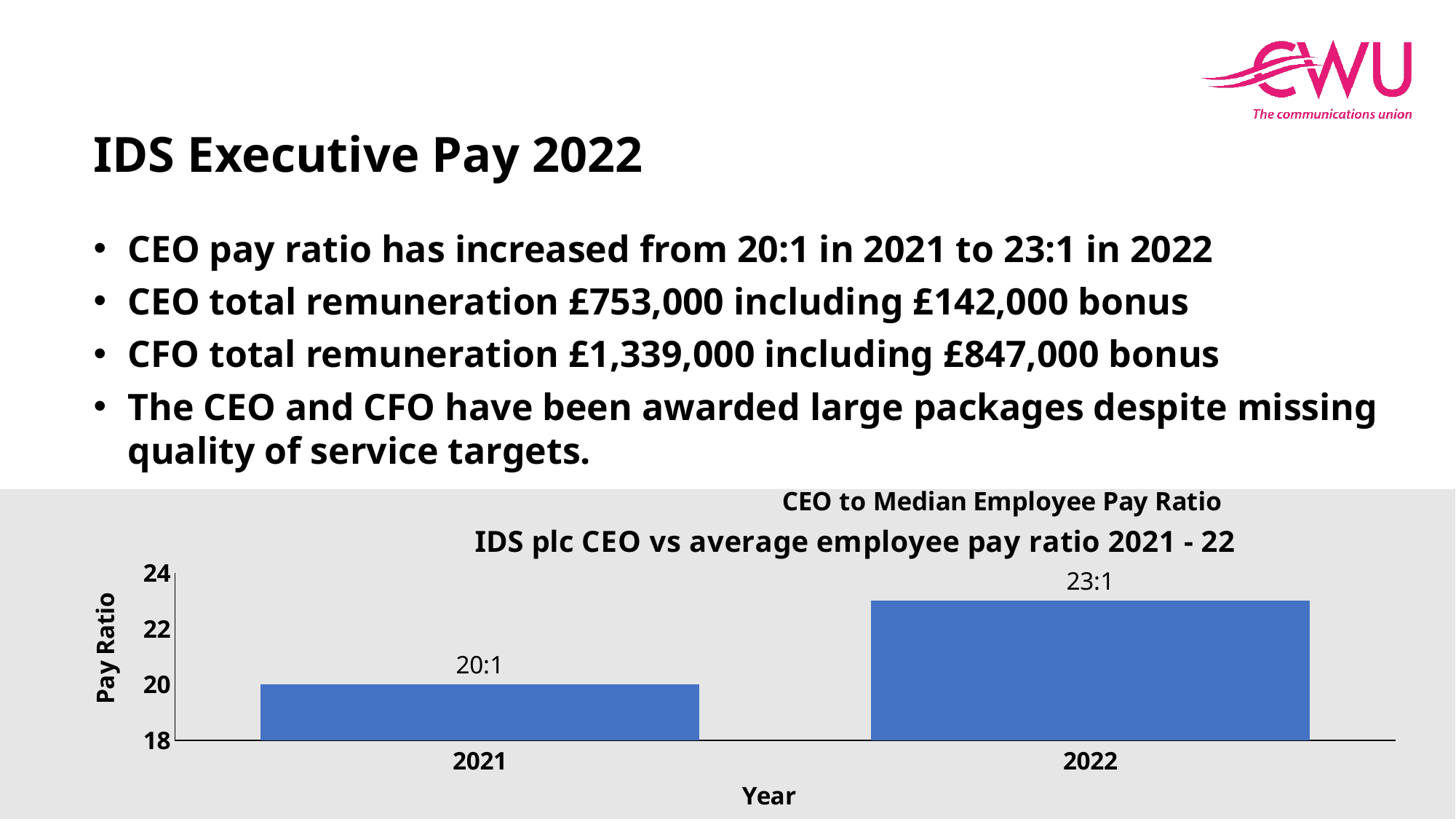
Which year has the lower pay ratio? 2021 Is the pay ratio for 2021 greater or less than 22? less What is the pay ratio shown for 2021? 20:1 What is the pay ratio shown for 2022? 23:1 How many years are plotted on the chart? 2 What kind of chart is shown on the slide? Bar chart What is the label on the horizontal axis of the chart? Year Is the pay ratio for 2022 greater or less than 22? greater Does the pay ratio rise or fall from 2021 to 2022? Rise Which year has the higher pay ratio? 2022 What is the label on the vertical axis of the chart? Pay Ratio By how much did the pay ratio increase from 2021 to 2022? 3